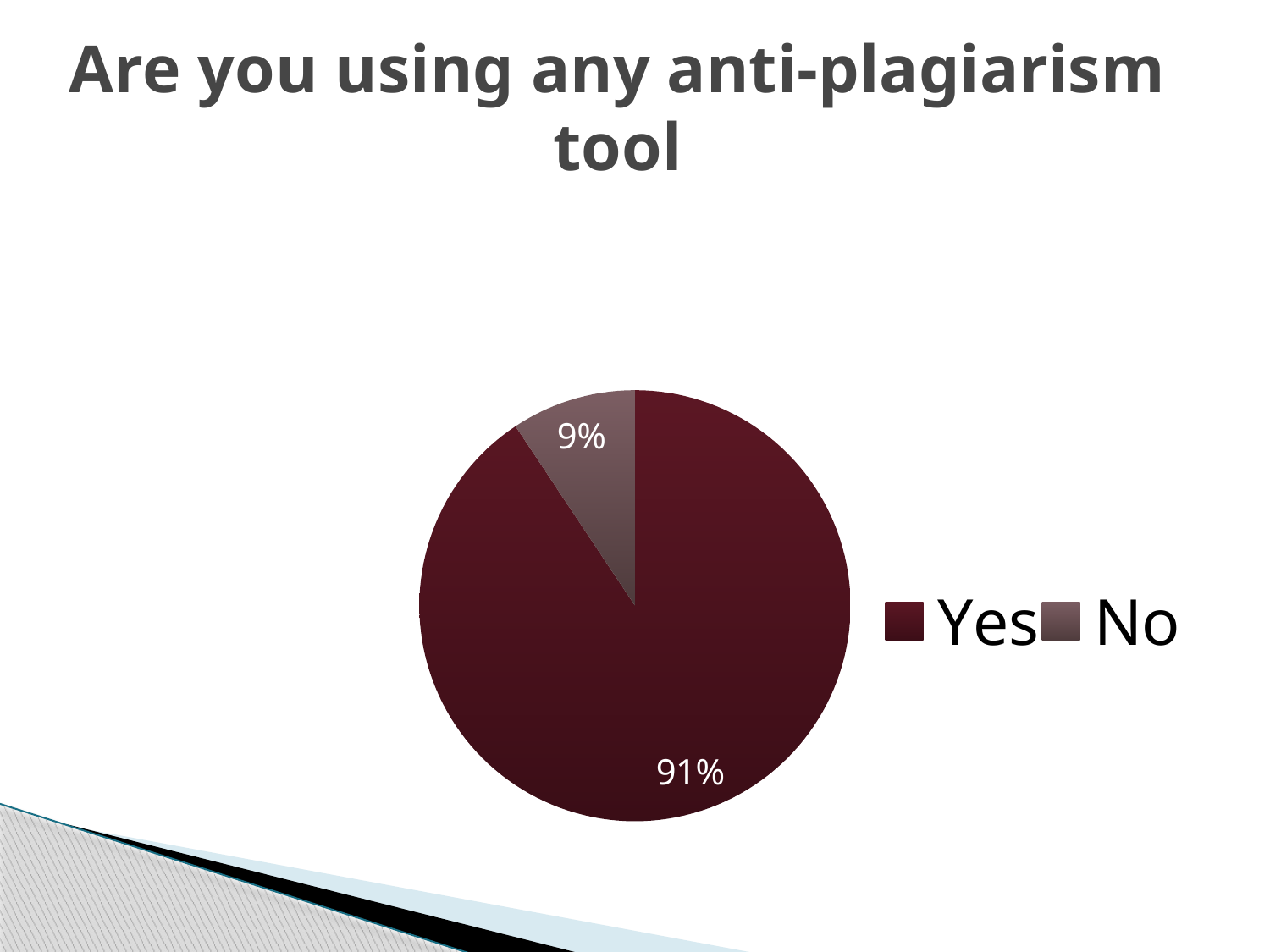
What share of the pie does the No slice represent? 9% What is the difference in percentage points between the Yes and No slices? 82 Which response has the largest share of the pie? Yes What percentage of respondents answered Yes? 91% What is the title of the chart? Are you using any anti-plagiarism tool What percentage of respondents answered No? 9% How many slices does the pie chart have? 2 Which slice is larger, Yes or No? Yes How many entries does the legend list? 2 What kind of chart is shown on the slide? pie chart Which response has the smallest share of the pie? No What are the two legend entries shown on the slide? Yes and No